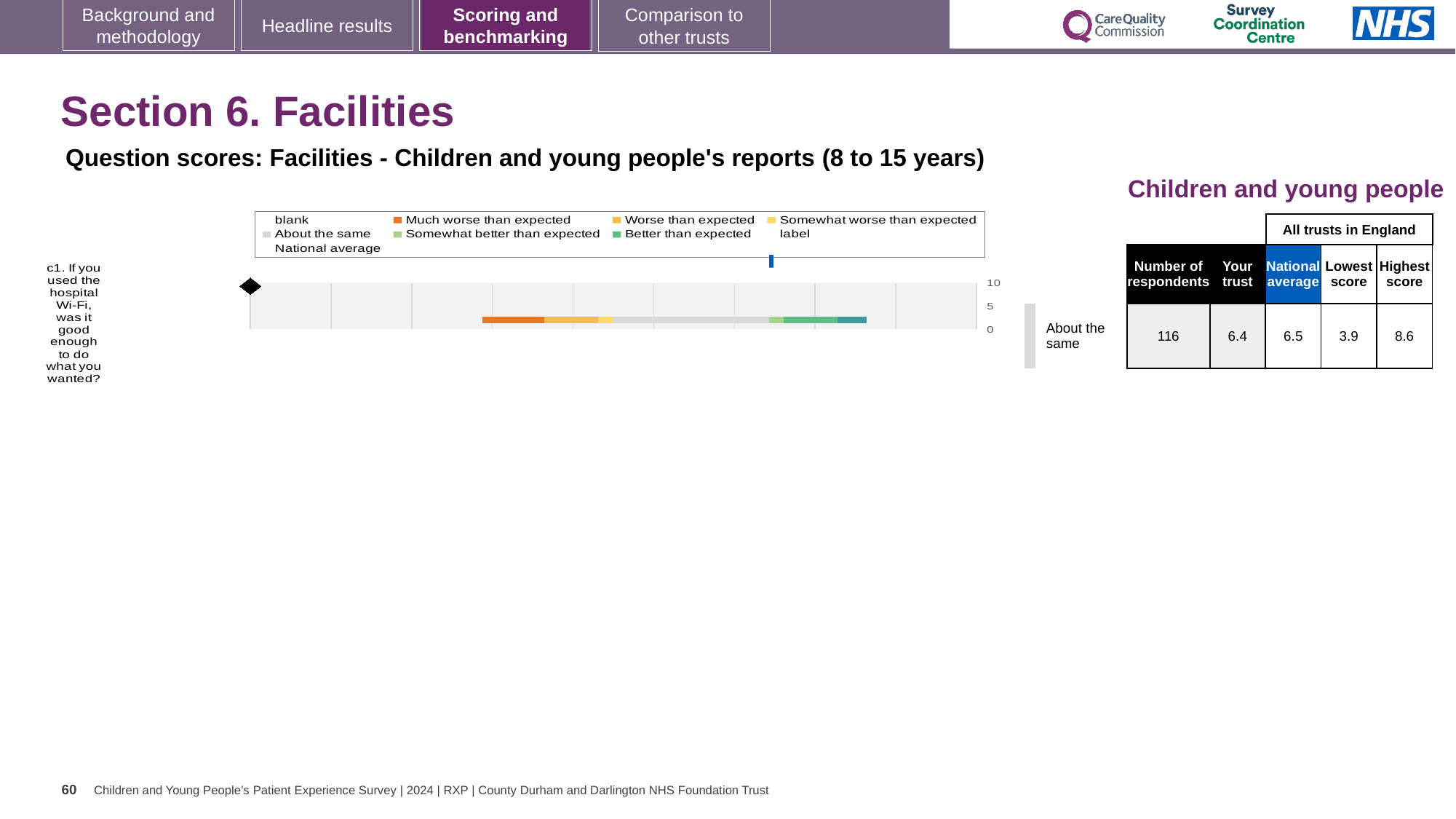
In the table beside the chart, what is the number of respondents for question c1? 116 How many survey questions (categories) are plotted in the chart? 1 Which is larger for question c1: the 'Your trust' score or the national average? National average In the table beside the chart, what is the lowest score among all trusts in England for question c1? 3.9 In the table beside the chart, what is the highest score among all trusts in England for question c1? 8.6 In the table beside the chart, what is the 'Your trust' score for question c1 about hospital Wi-Fi? 6.4 In the table beside the chart, what is the national average score for question c1? 6.5 What is the highest tick value shown on the chart's axis? 10 How many entries does the chart's legend list? 9 What kind of chart is shown on the slide? bar chart Which legend entry is shown in orange? Much worse than expected What is the difference between the highest score (8.6) and the lowest score (3.9) for question c1? 4.7